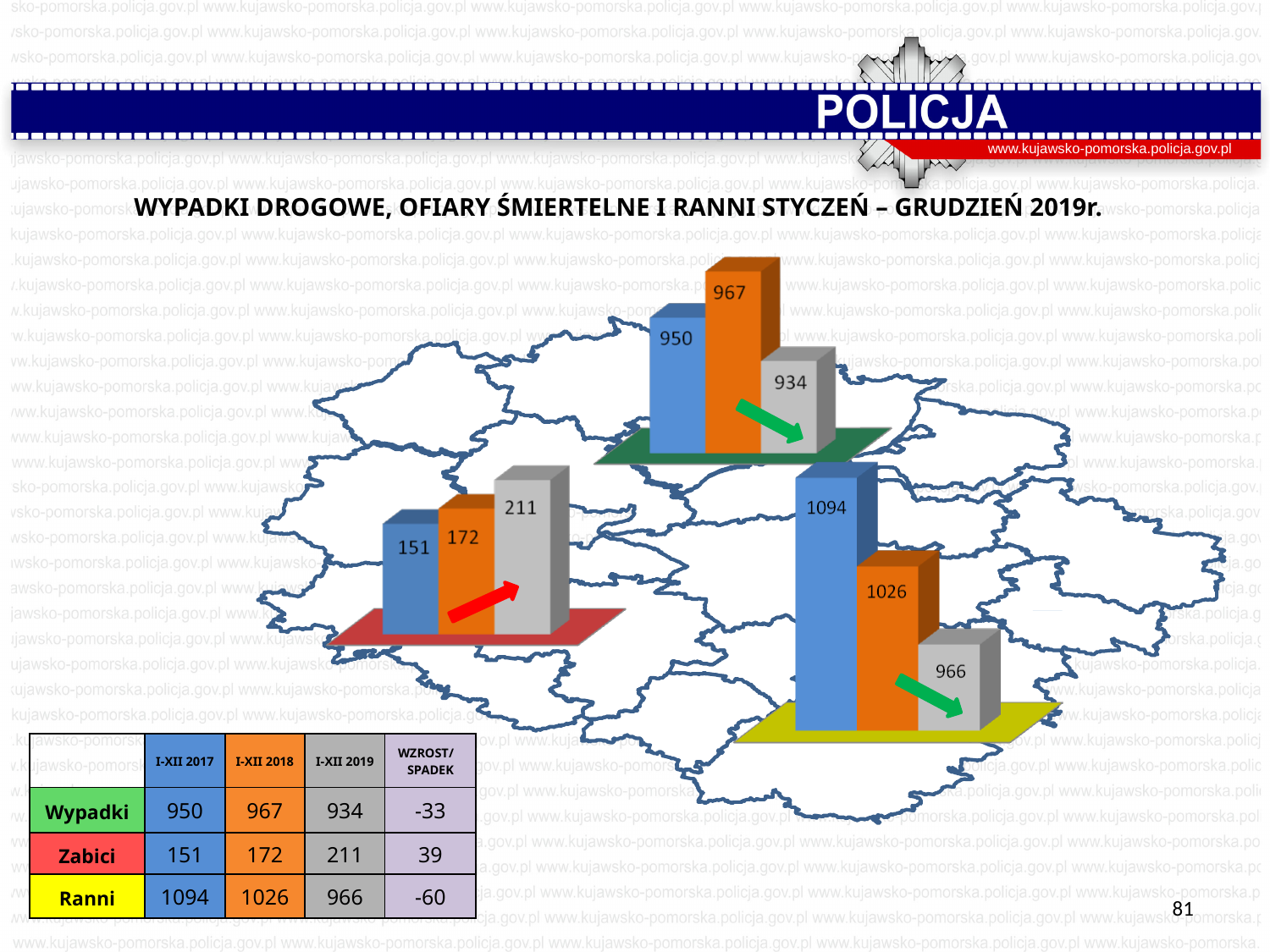
On the chart with the yellow base (bottom right of the map), what is the value of the blue bar? 1094 On the chart with the red base (left of the map), what is the value of the grey bar? 211 On the chart with the red base (left of the map), which bar is the lowest? the blue bar (151) On the chart with the green base (top of the map), which bar is the highest? the orange bar (967) On the chart with the red base (left of the map), do the values rise or fall from left to right? rise On the chart with the green base (top of the map), what is the difference between the orange bar and the grey bar? 33 On the chart with the green base (top of the map), what is the value of the grey bar? 934 On the chart with the red base (left of the map), what is the difference between the grey bar and the orange bar? 39 On the chart with the green base (top of the map), what is the value of the blue bar? 950 How many bars does the chart with the yellow base (bottom right of the map) have? 3 On the chart with the yellow base (bottom right of the map), do the values rise or fall from left to right? fall On the chart with the yellow base (bottom right of the map), which is larger, the orange bar or the grey bar? the orange bar (1026)